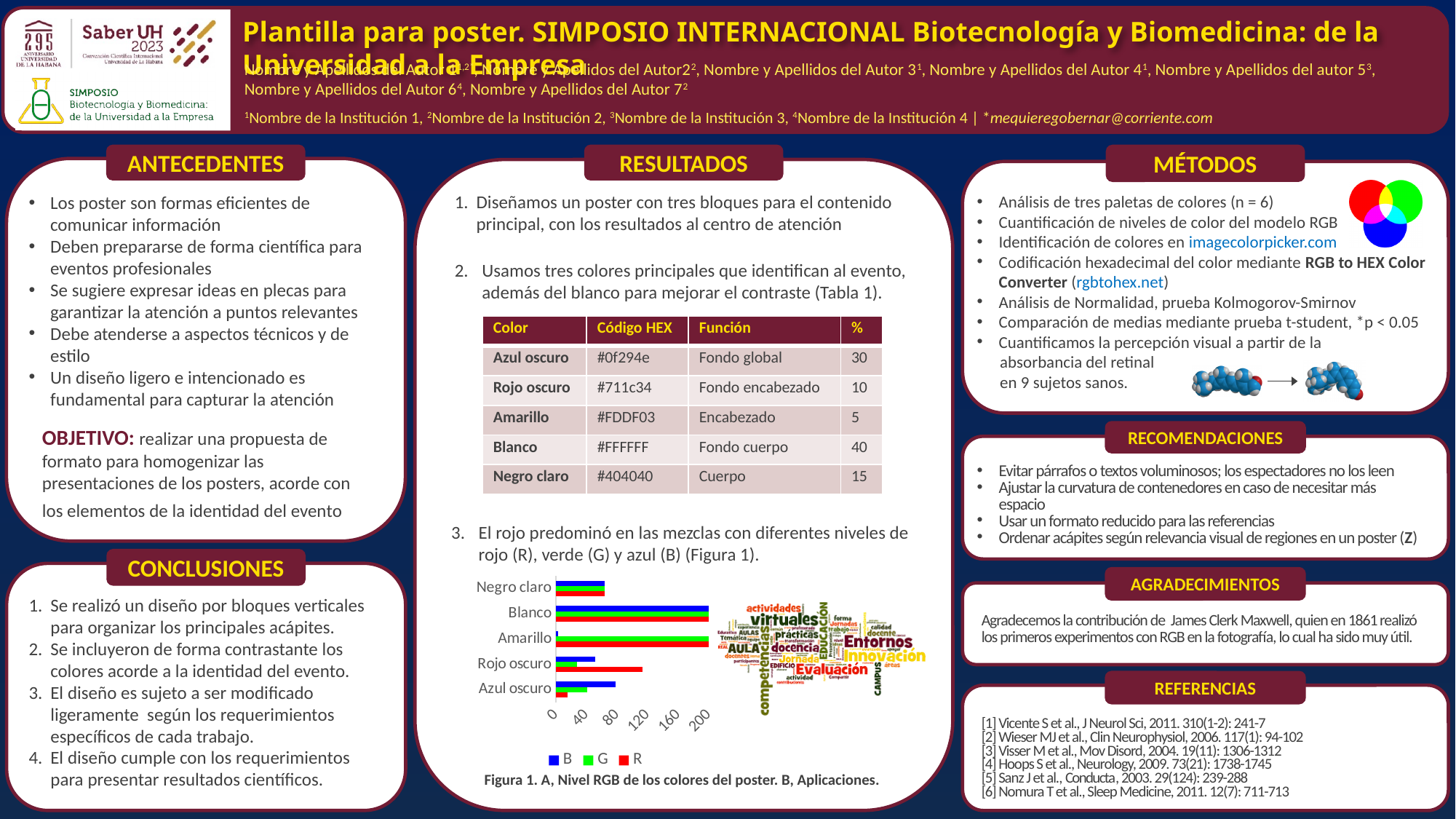
How many colour categories are plotted in Figura 1? 5 In Figura 1, which is larger: the B value for Azul oscuro or the B value for Rojo oscuro? Azul oscuro In Figura 1, which is larger: the R value for Rojo oscuro or the R value for Azul oscuro? Rojo oscuro How many series does the legend of Figura 1 list? 3 In Figura 1, is the R value for Azul oscuro greater or less than 40? less What kind of chart is Figura 1? bar chart In Figura 1, is the B value for Amarillo greater or less than 40? less In Figura 1, is the B value for Blanco greater or less than 200? greater What are the legend entries in Figura 1? B, G, R In Figura 1, which category has the lowest B value? Amarillo In Figura 1, which category has the lowest R value? Azul oscuro